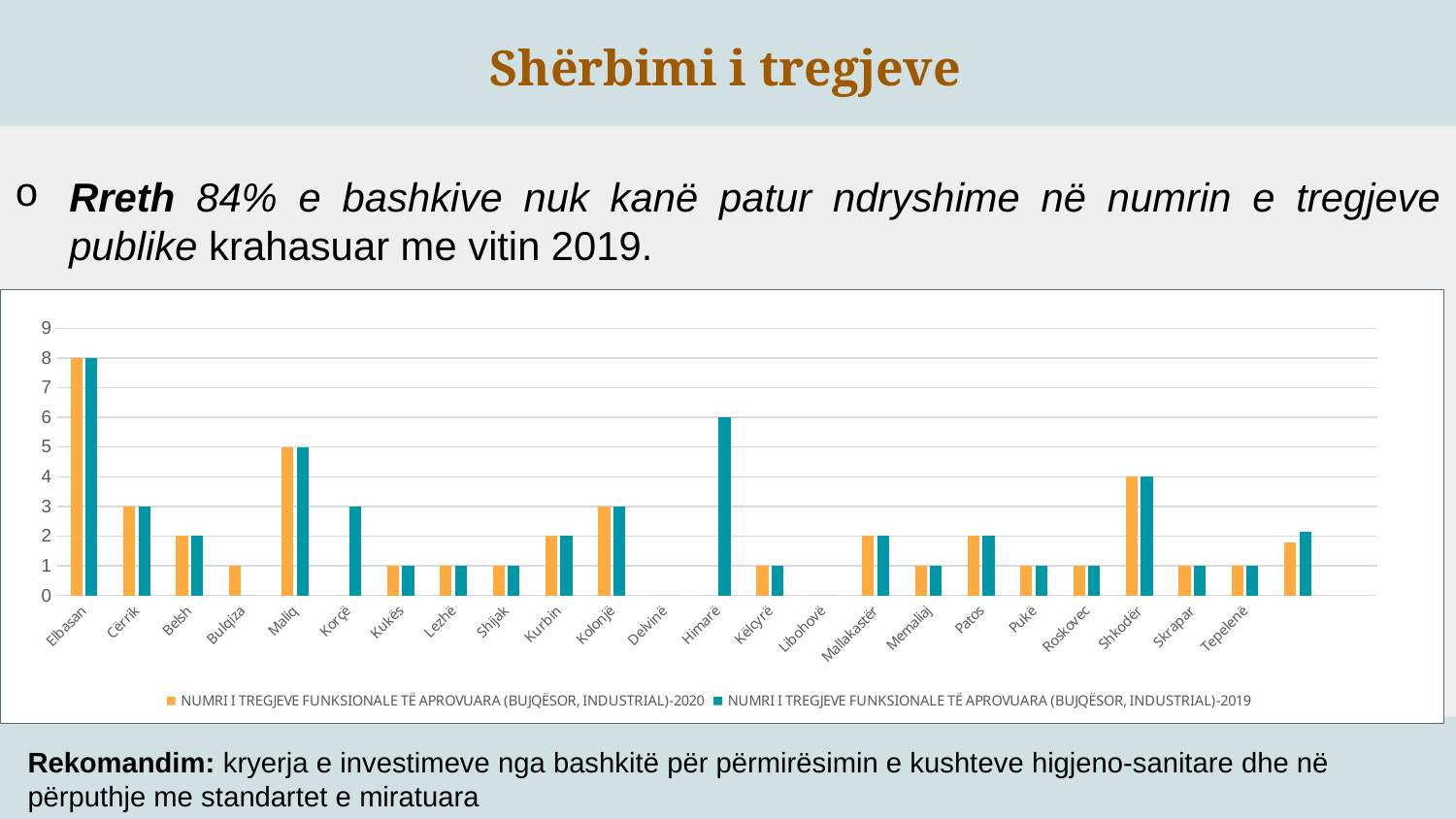
What is the value for Korçë in the 2019 series? 3 What is the value for Shkodër in the 2019 series? 4 Which colour represents the 2019 series in the chart? teal What is the difference between the 2020 values for Elbasan and Maliq? 3 What is the value for Himarë in the 2019 series? 6 Which category has the highest value in the 2020 series? Elbasan Is the 2019 value for Himarë greater or less than 5? greater What is the value for Maliq in the 2020 series? 5 How many series does the chart legend list? 2 What kind of chart is shown on the slide? bar chart Which is larger in the 2019 series: Himarë or Maliq? Himarë What is the value for Elbasan in the 2020 series? 8